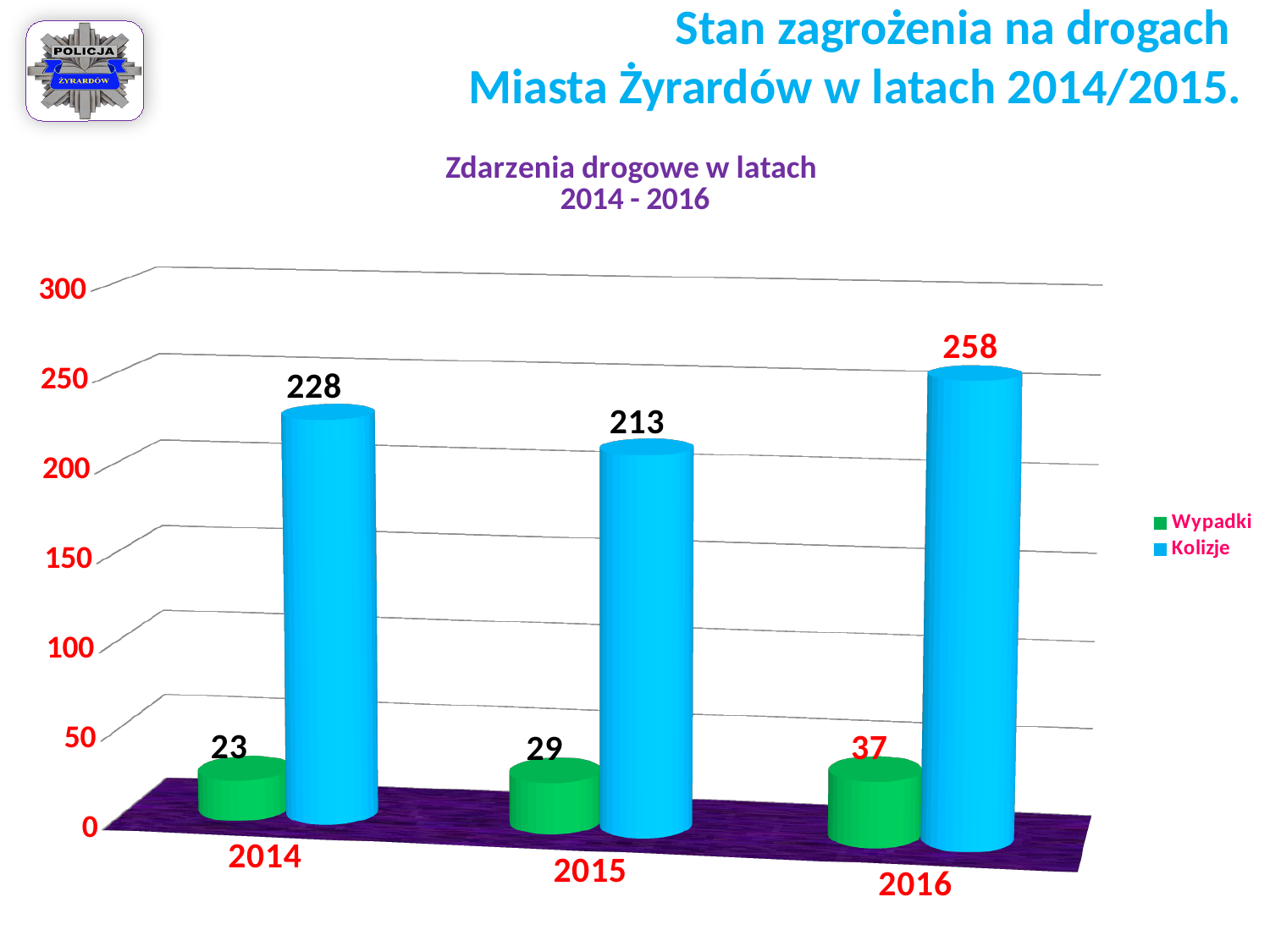
How many years are shown on the x axis? 3 Which year has the lowest value for Wypadki? 2014 What is the difference between Kolizje in 2016 and Kolizje in 2015? 45 Which year has the highest value for Kolizje? 2016 Do the Wypadki values rise or fall from 2014 to 2016? rise What is the value for Wypadki in 2016? 37 What is the value for Kolizje in 2014? 228 How many series does the legend list? 2 What is the difference between Wypadki in 2016 and Wypadki in 2014? 14 Which is larger, Kolizje in 2014 or Kolizje in 2015? Kolizje in 2014 What is the value for Kolizje in 2015? 213 What kind of chart is shown on the slide? bar chart